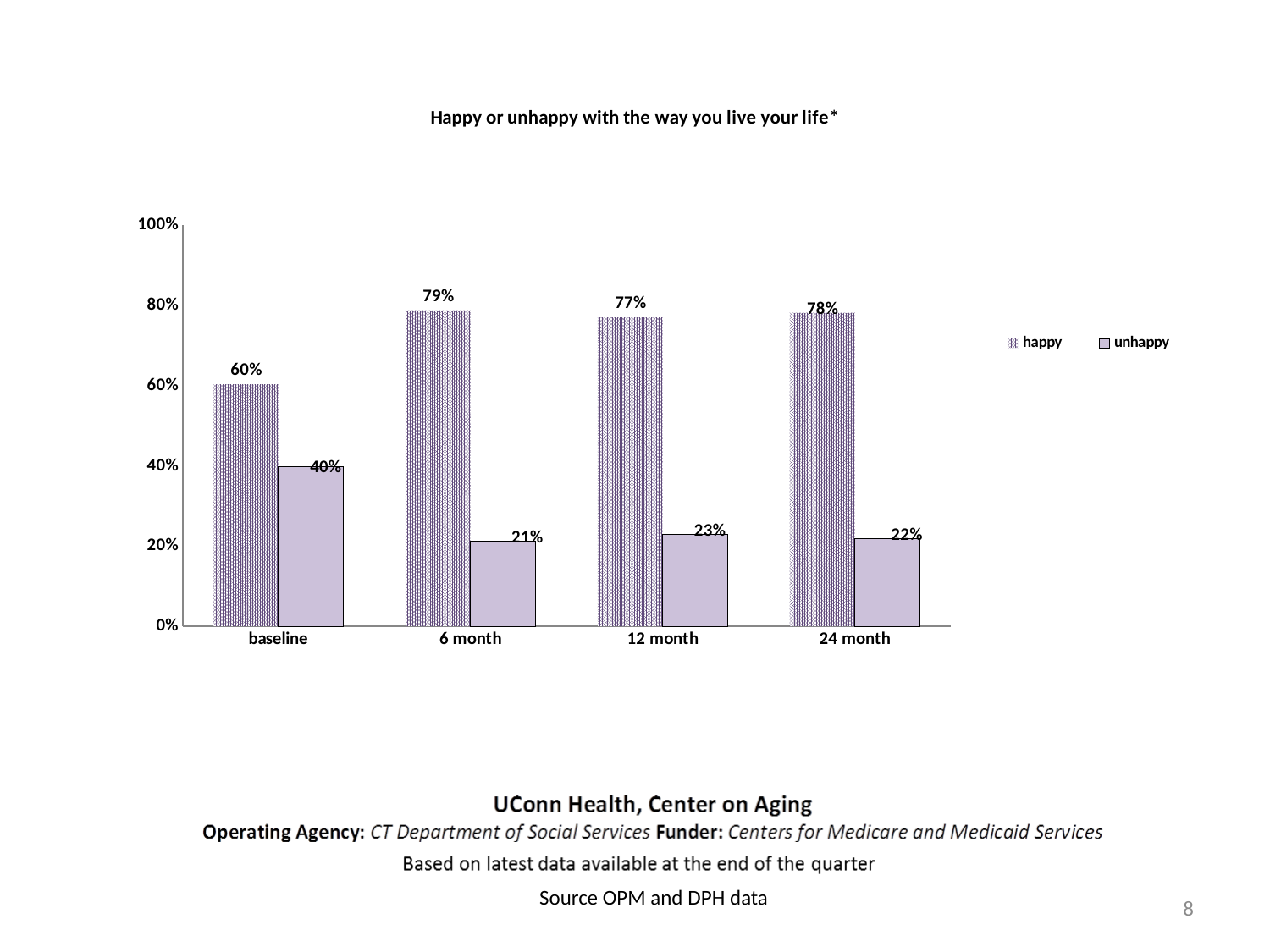
What is the happy value at 24 month? 78% At which time point is the unhappy percentage lowest? 6 month How many time points are shown on the x axis? 4 What percentage of respondents were happy at baseline? 60% What is the title of the chart? Happy or unhappy with the way you live your life* At which time point is the happy percentage highest? 6 month What type of chart is shown on the slide? bar chart Which is larger, the unhappy value at baseline or the unhappy value at 24 month? baseline By how much did the happy percentage increase from baseline to 6 month? 19% How many series does the legend list? 2 What is the unhappy value at 12 month? 23% What is the difference between the happy and unhappy values at baseline? 20%